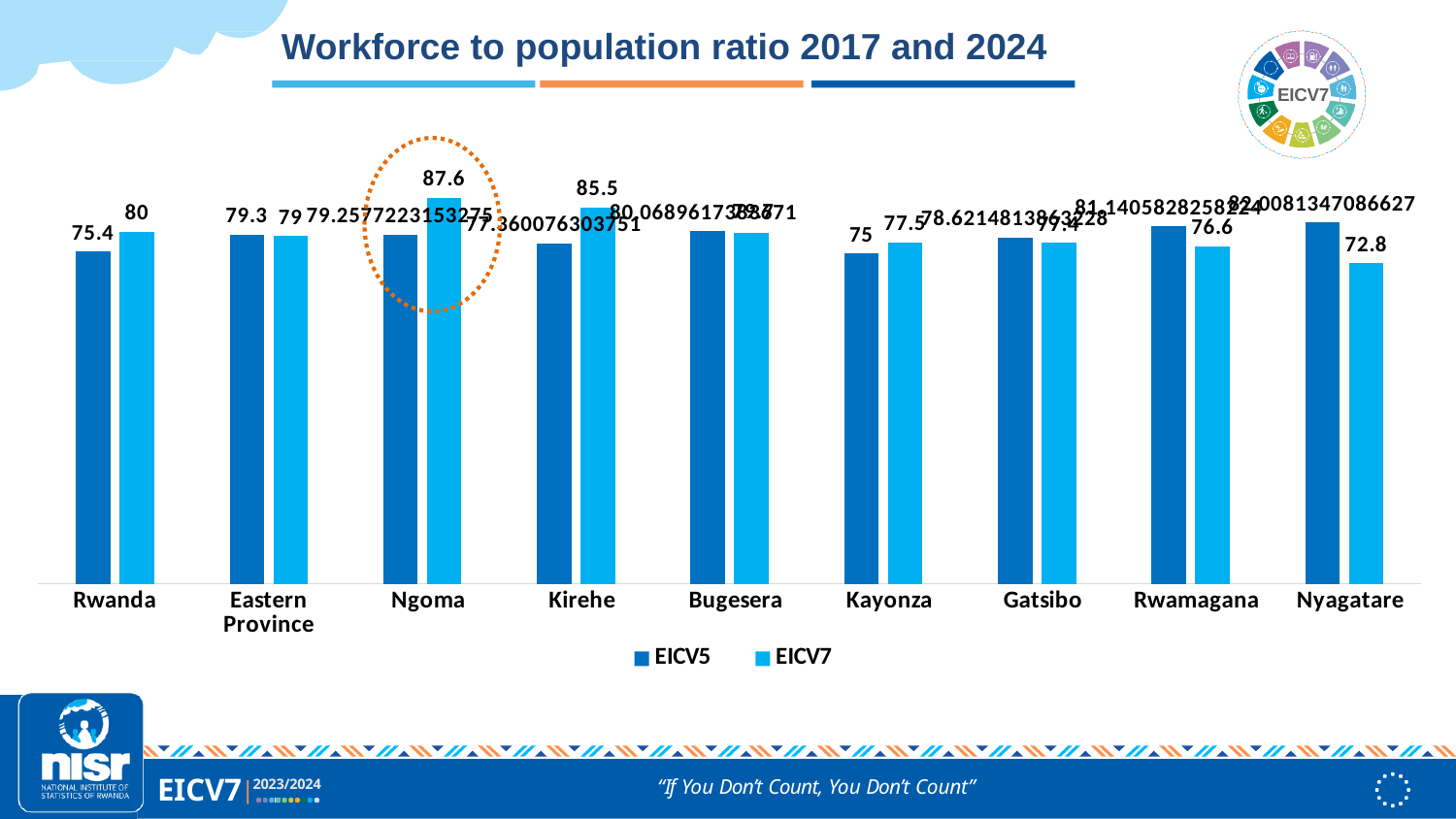
How many categories are shown on the x axis? 9 What is the EICV7 value for Kirehe? 85.5 What is the difference between the EICV7 and EICV5 values for Rwanda? 4.6 What is the EICV7 value for Ngoma? 87.6 Which category has the lowest EICV7 value? Nyagatare What is the EICV5 value for Rwanda? 75.4 What kind of chart is shown on the slide? Bar chart How many series does the legend list? 2 For Nyagatare, which series has the larger value, EICV5 or EICV7? EICV5 Which category has the highest EICV7 value? Ngoma What is the EICV5 value for Eastern Province? 79.3 What is the EICV7 value for Nyagatare? 72.8